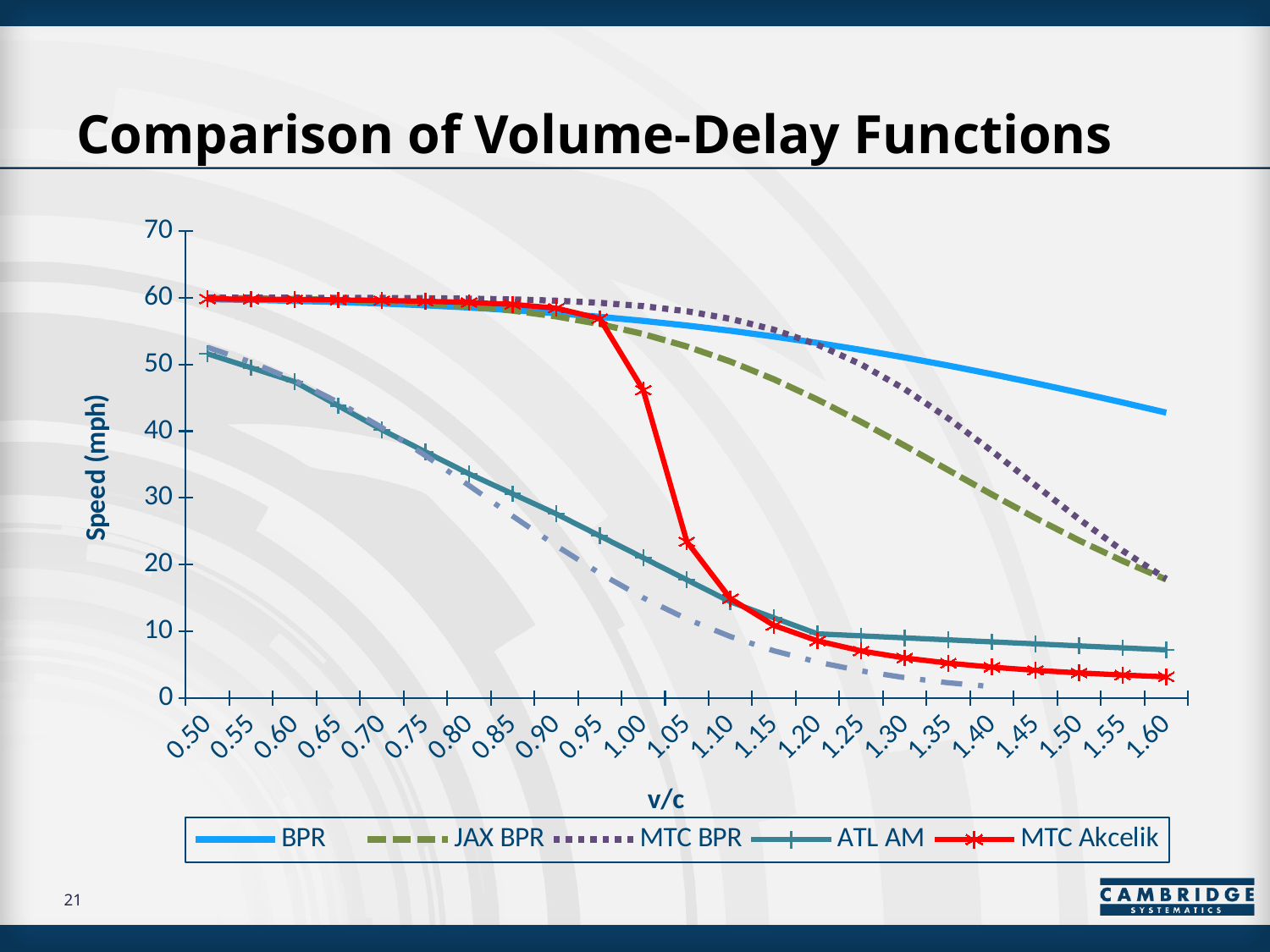
Is the value for BPR at v/c 1.60 greater or less than 40? greater At v/c 1.60, which series has the highest speed? BPR Is the value for JAX BPR at v/c 1.60 greater or less than 20? less What is the title of the chart? Comparison of Volume-Delay Functions At v/c 1.00, which is larger, the speed for ATL AM or for MTC Akcelik? MTC Akcelik Is the value for MTC Akcelik at v/c 1.60 greater or less than 10? less At v/c 1.60, which series has the lowest speed? MTC Akcelik What is the label of the vertical axis? Speed (mph) Do the speed values rise or fall as v/c increases along the x axis? fall How many series does the legend list? 5 What kind of chart is shown on the slide? line chart